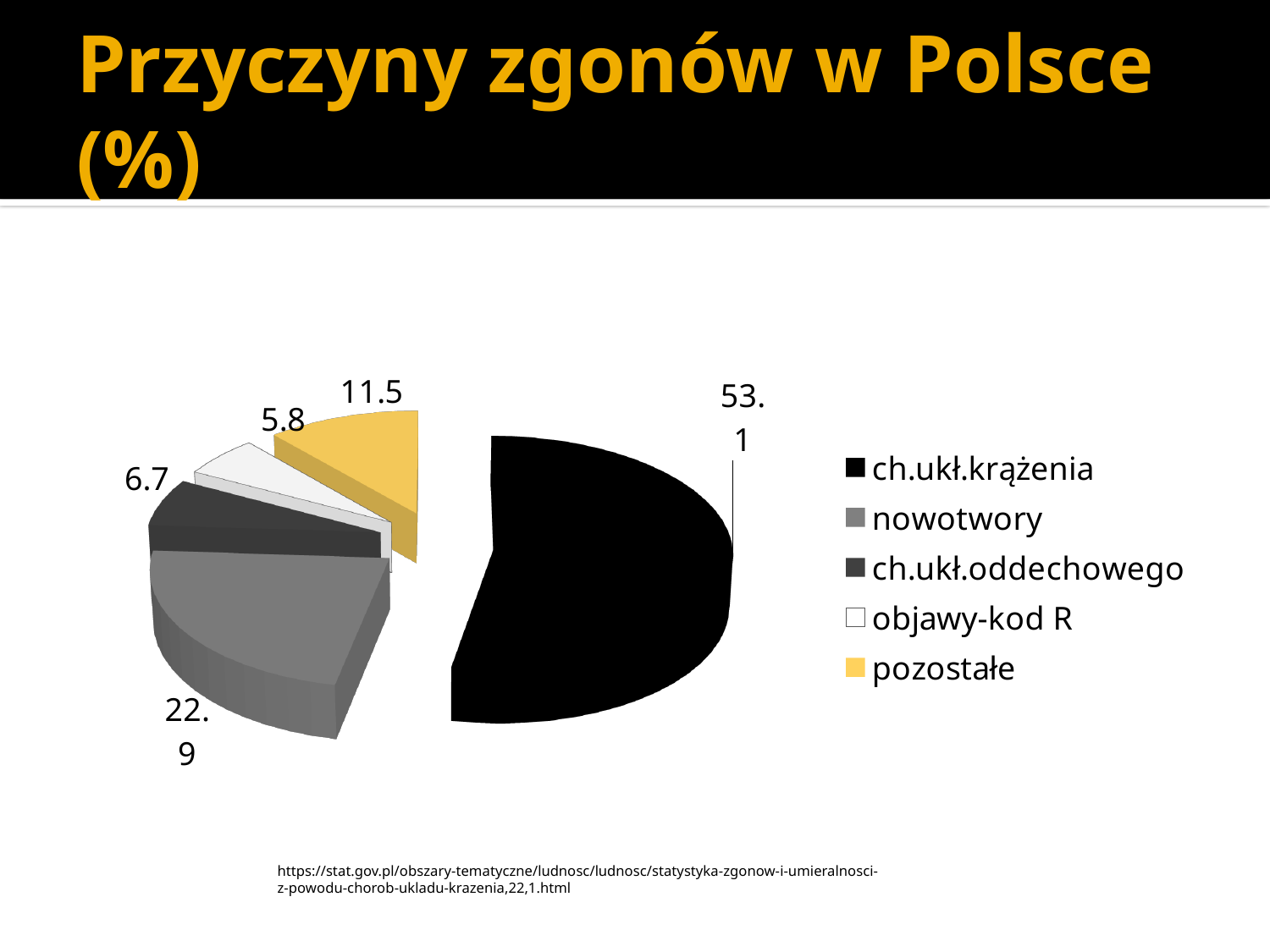
What is the title of the chart on the slide? Przyczyny zgonów w Polsce (%) What is the value for objawy-kod R? 5.8 Which category has the largest share of the pie? ch.ukł.krążenia What kind of chart is shown on the slide? pie chart What is the value for pozostałe? 11.5 What is the value for ch.ukł.krążenia? 53.1 What is the value for nowotwory? 22.9 Which category has the smallest share of the pie? objawy-kod R How many categories does the pie chart have? 5 What is the difference between the values for ch.ukł.krążenia and nowotwory? 30.2 Which is larger, the value for pozostałe or the value for ch.ukł.oddechowego? pozostałe What is the value for ch.ukł.oddechowego? 6.7